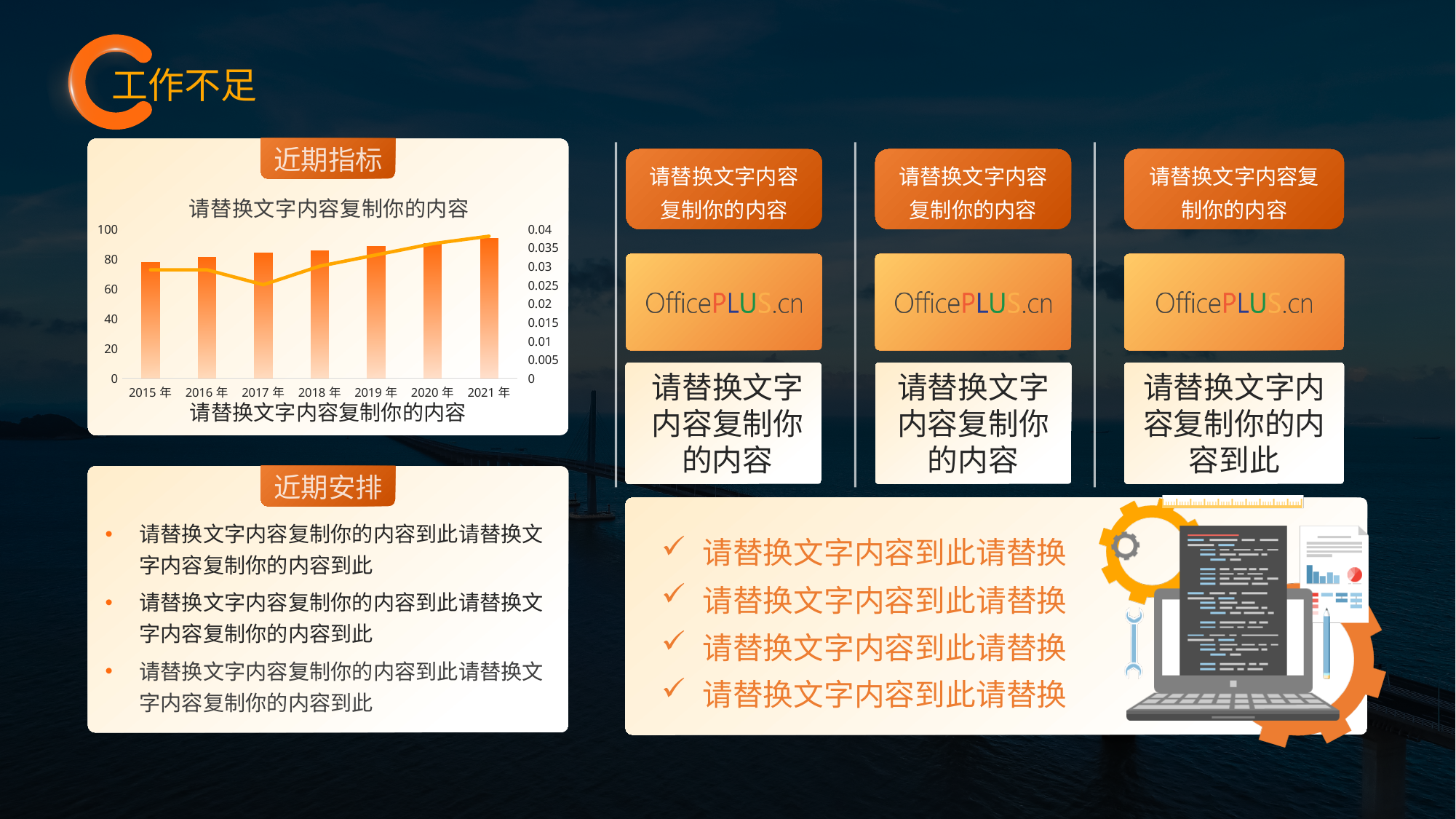
How many years are shown on the x axis of the chart? 7 Which year has the shortest bar in the chart? 2015 年 Which year has the tallest bar in the chart? 2021 年 In which year does the line reach its lowest point? 2017 年 Is the line value for 2017 年 greater or less than 0.03? less What kind of chart is shown under 近期指标? A bar chart combined with a line What is the title of the chart under 近期指标? 请替换文字内容复制你的内容 What is the maximum value shown on the right-hand axis of the chart? 0.04 Which bar is taller, 2021 年 or 2015 年? 2021 年 Is the bar value for 2021 年 greater or less than 100? less Do the bar values rise or fall from 2015 年 to 2021 年? rise Is the bar value for 2015 年 greater or less than 60? greater